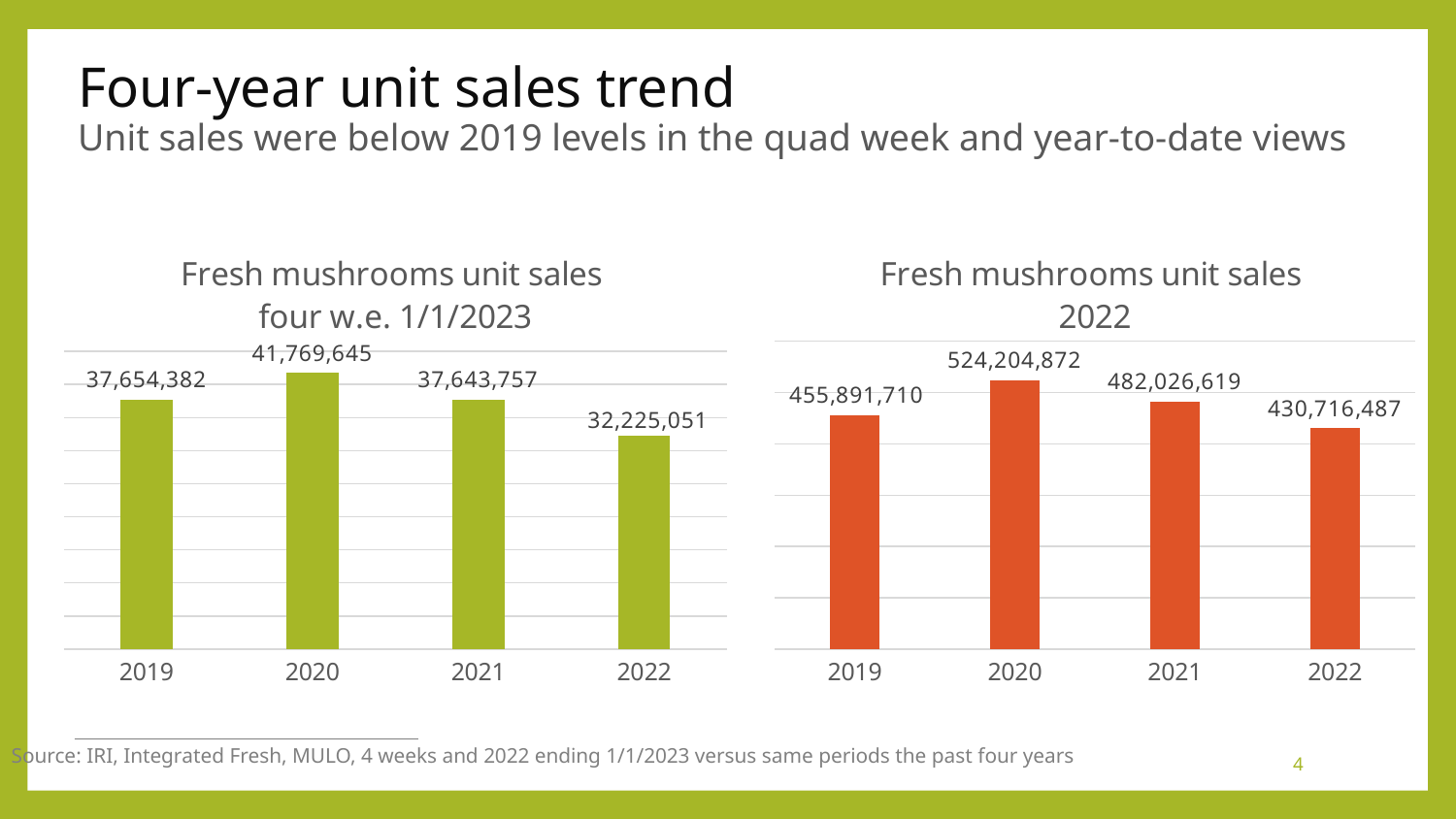
In the 'Fresh mushrooms unit sales 2022' chart, what is the value for 2021? 482,026,619 In the 'Fresh mushrooms unit sales 2022' chart, which year has the lowest value? 2022 In the 'Fresh mushrooms unit sales four w.e. 1/1/2023' chart, what is the value for 2020? 41,769,645 In the 'Fresh mushrooms unit sales four w.e. 1/1/2023' chart, what is the difference between the 2020 and 2022 values? 9,544,594 In the 'Fresh mushrooms unit sales 2022' chart, do the values rise or fall from 2020 to 2022? Fall How many years are shown in the 'Fresh mushrooms unit sales 2022' chart? 4 In the 'Fresh mushrooms unit sales 2022' chart, what is the difference between the 2020 and 2019 values? 68,313,162 In the 'Fresh mushrooms unit sales four w.e. 1/1/2023' chart, which year has the highest value? 2020 In the 'Fresh mushrooms unit sales 2022' chart, which is larger, the value for 2021 or the value for 2022? 2021 In the 'Fresh mushrooms unit sales four w.e. 1/1/2023' chart, what is the value for 2022? 32,225,051 In the 'Fresh mushrooms unit sales 2022' chart, what is the value for 2019? 455,891,710 What type of chart is the 'Fresh mushrooms unit sales four w.e. 1/1/2023' chart? Bar chart